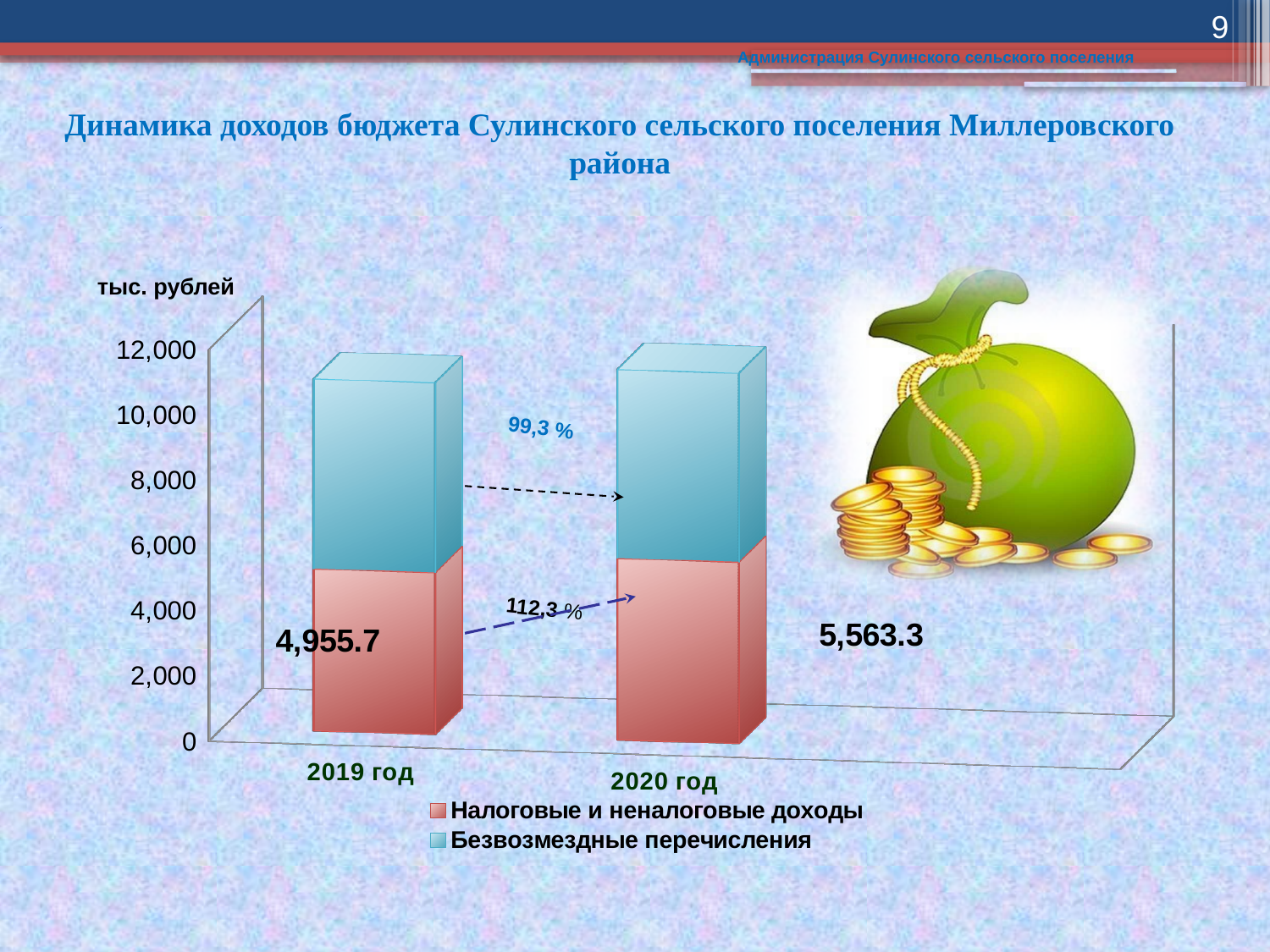
What unit is indicated above the vertical axis of the chart? тыс. рублей What value is printed on the 2019 год bar? 4,955.7 How many series does the chart legend list? 2 What is the difference between the printed values 5,563.3 (2020 год) and 4,955.7 (2019 год)? 607.6 What kind of chart is shown on the slide? Stacked bar chart Is the total height of the 2019 год stacked bar greater or less than 10,000? greater Do the total bar heights rise or fall from 2019 год to 2020 год? rise Which is larger, the value printed for 2019 год (4,955.7) or for 2020 год (5,563.3)? 2020 год What value is printed next to the 2020 год bar? 5,563.3 How many categories (years) are shown on the x axis of the chart? 2 Which series is shown in blue according to the legend? Безвозмездные перечисления